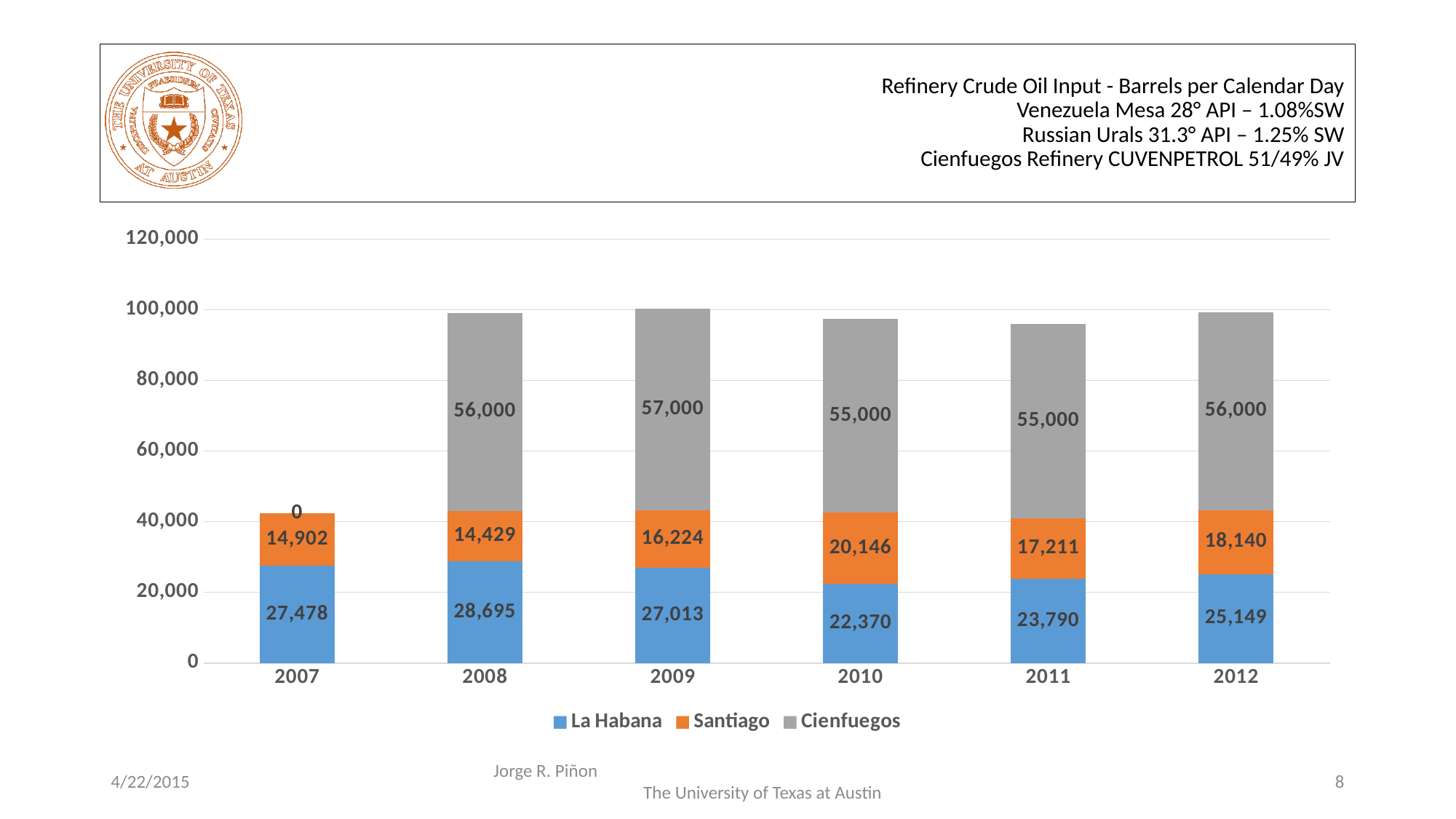
What is the La Habana value for 2010? 22,370 What is the Santiago value for 2011? 17,211 What is the total of the stacked bar for 2008? 99,124 How many series does the legend list? 3 How many years are shown on the x axis? 6 What is the difference between the Santiago values for 2010 and 2009? 3,922 What kind of chart is shown on the slide? stacked bar chart In which year is the Santiago value lowest? 2008 Is the total stacked bar for 2007 greater or less than 60,000? less What is the Cienfuegos value for 2009? 57,000 In which year is the La Habana value highest? 2008 Which is larger, the La Habana value for 2011 or for 2012? 2012